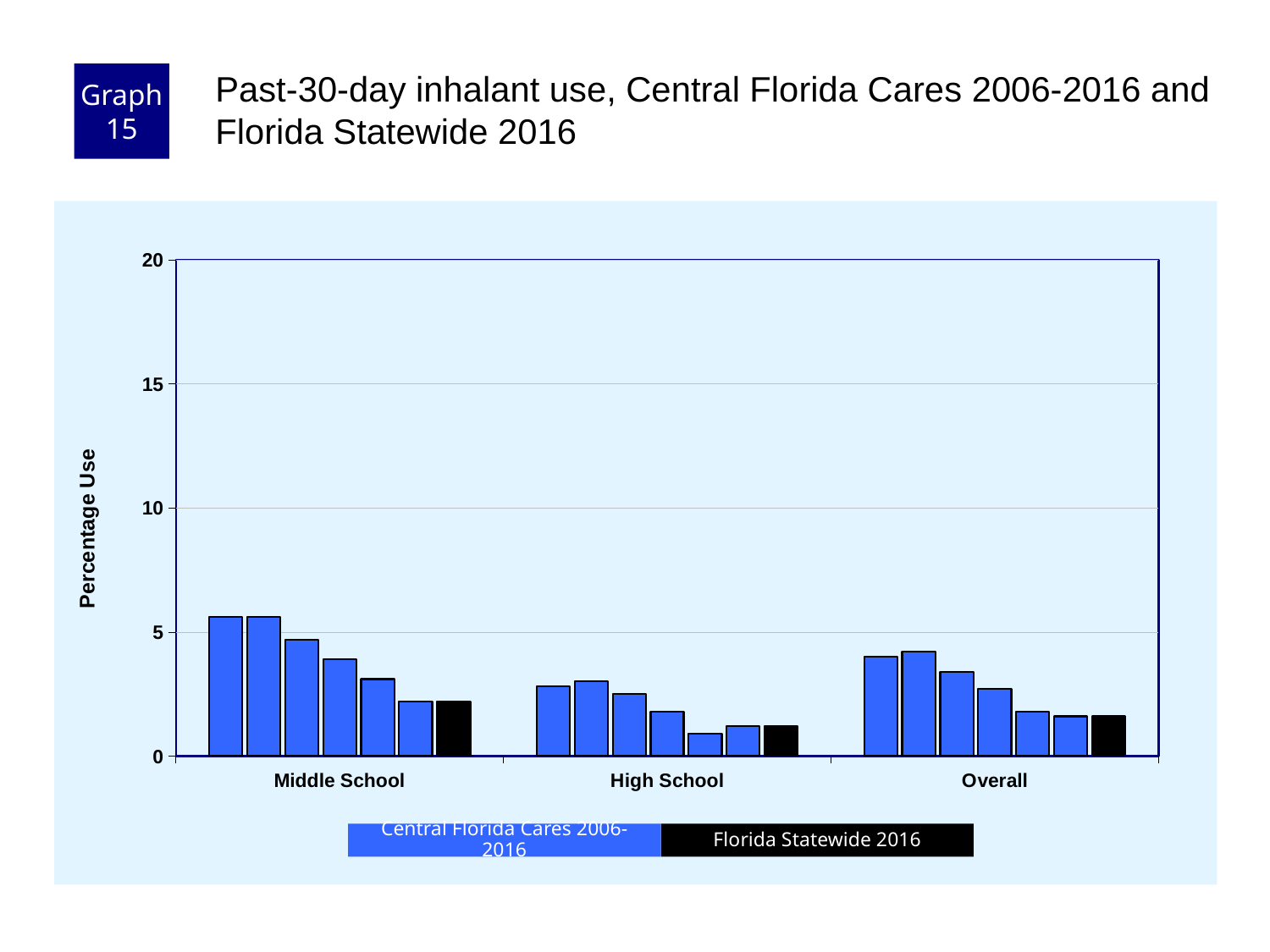
How many categories are shown on the x axis? 3 What is the highest value shown on the y axis? 20 Is the Florida Statewide 2016 value for High School greater or less than 5? less Is the Florida Statewide 2016 value for Middle School greater or less than 5? less How many series does the legend list? 2 Which series is shown in black in the legend? Florida Statewide 2016 Which is larger, the Florida Statewide 2016 value for Middle School or for High School? Middle School Which category has the tallest bar overall? Middle School Do the Central Florida Cares 2006-2016 bars for Middle School generally rise or fall from left to right? fall What is the label of the y axis? Percentage Use Is the tallest Middle School bar greater or less than 10? less What kind of chart is shown on the slide? bar chart